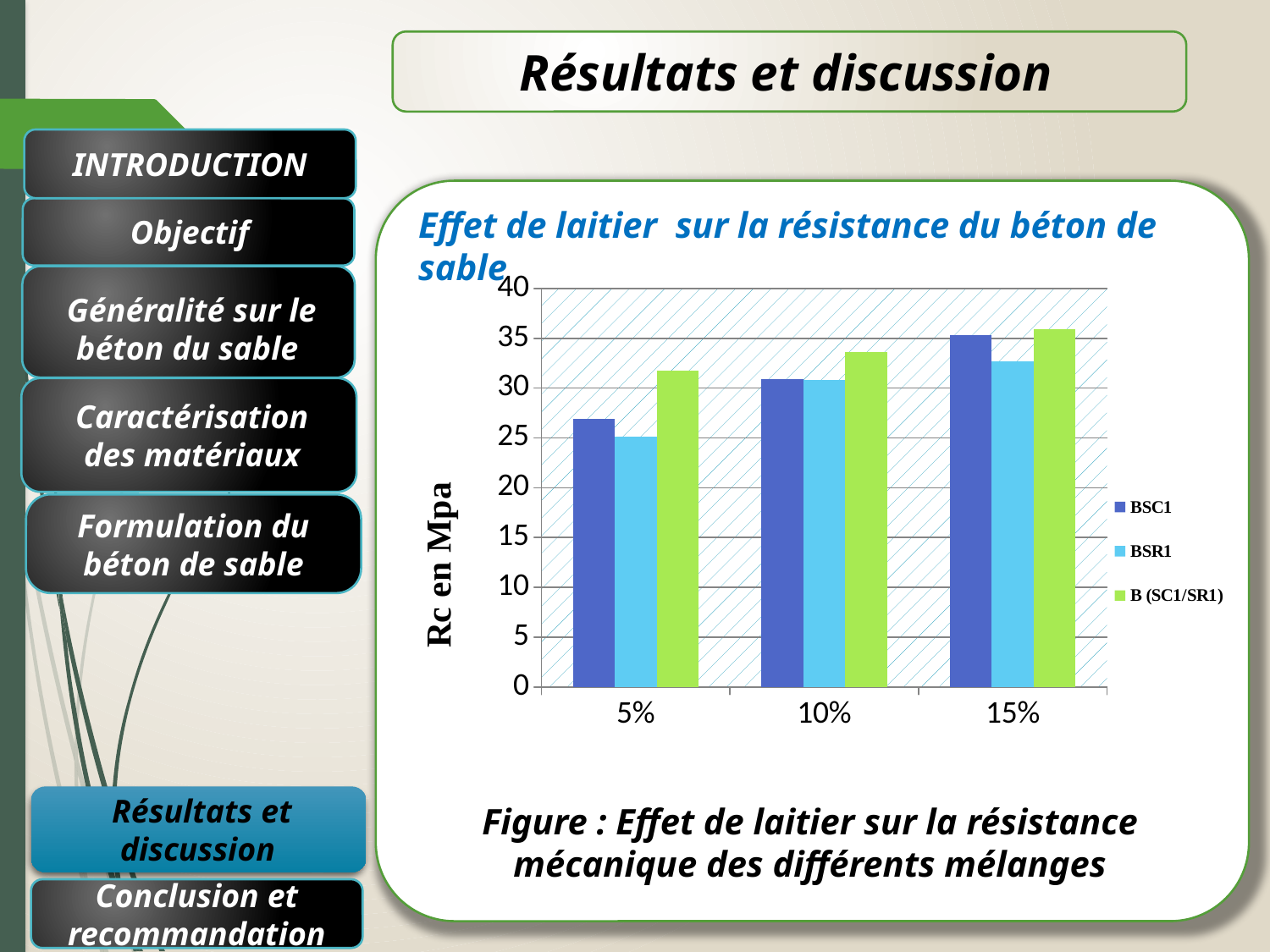
Which series has the lowest value at 5%? BSR1 How many categories are shown on the x axis? 3 At 15%, which is larger, BSC1 or BSR1? BSC1 Is the value for BSC1 at 5% greater or less than 25? greater What is the label of the y axis? Rc en Mpa Do the values for BSC1 rise or fall from 5% to 15%? rise Which series has the highest value at 5%? B (SC1/SR1) How many series does the legend list? 3 Is the value for BSR1 at 5% greater or less than 30? less Is the value for B (SC1/SR1) at 10% greater or less than 30? greater What kind of chart is shown on the slide? bar chart